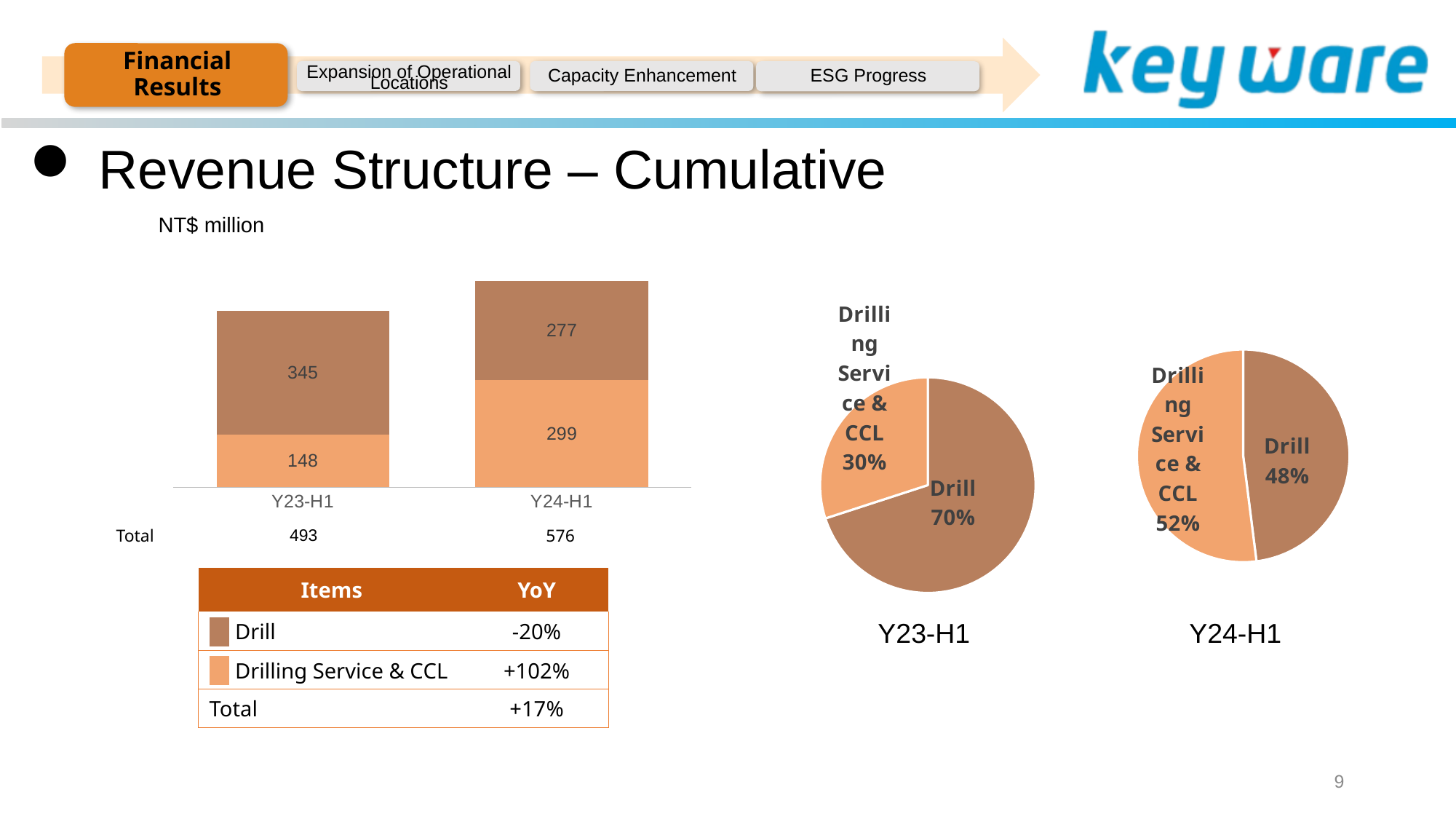
In the stacked bar chart, what is the difference between the Drill values for Y23-H1 and Y24-H1? 68 In the Y23-H1 pie chart, what share does Drill have? 70% In the Y24-H1 pie chart, which slice is larger, Drill or Drilling Service & CCL? Drilling Service & CCL In the stacked bar chart, does the total revenue rise or fall from Y23-H1 to Y24-H1? Rise What type of chart is the chart on the left showing Y23-H1 and Y24-H1 values? Stacked bar chart In the Y24-H1 pie chart, what share does Drilling Service & CCL have? 52% In the stacked bar chart, how many series are shown in the legend table? 2 In the stacked bar chart, what is the Drilling Service & CCL value for Y24-H1? 299 In the stacked bar chart, which period has the larger Drilling Service & CCL value, Y23-H1 or Y24-H1? Y24-H1 In the stacked bar chart, what is the total of the Y24-H1 bar? 576 In the stacked bar chart, what is the Drill value for Y23-H1? 345 In the stacked bar chart, how many periods are shown on the x axis? 2